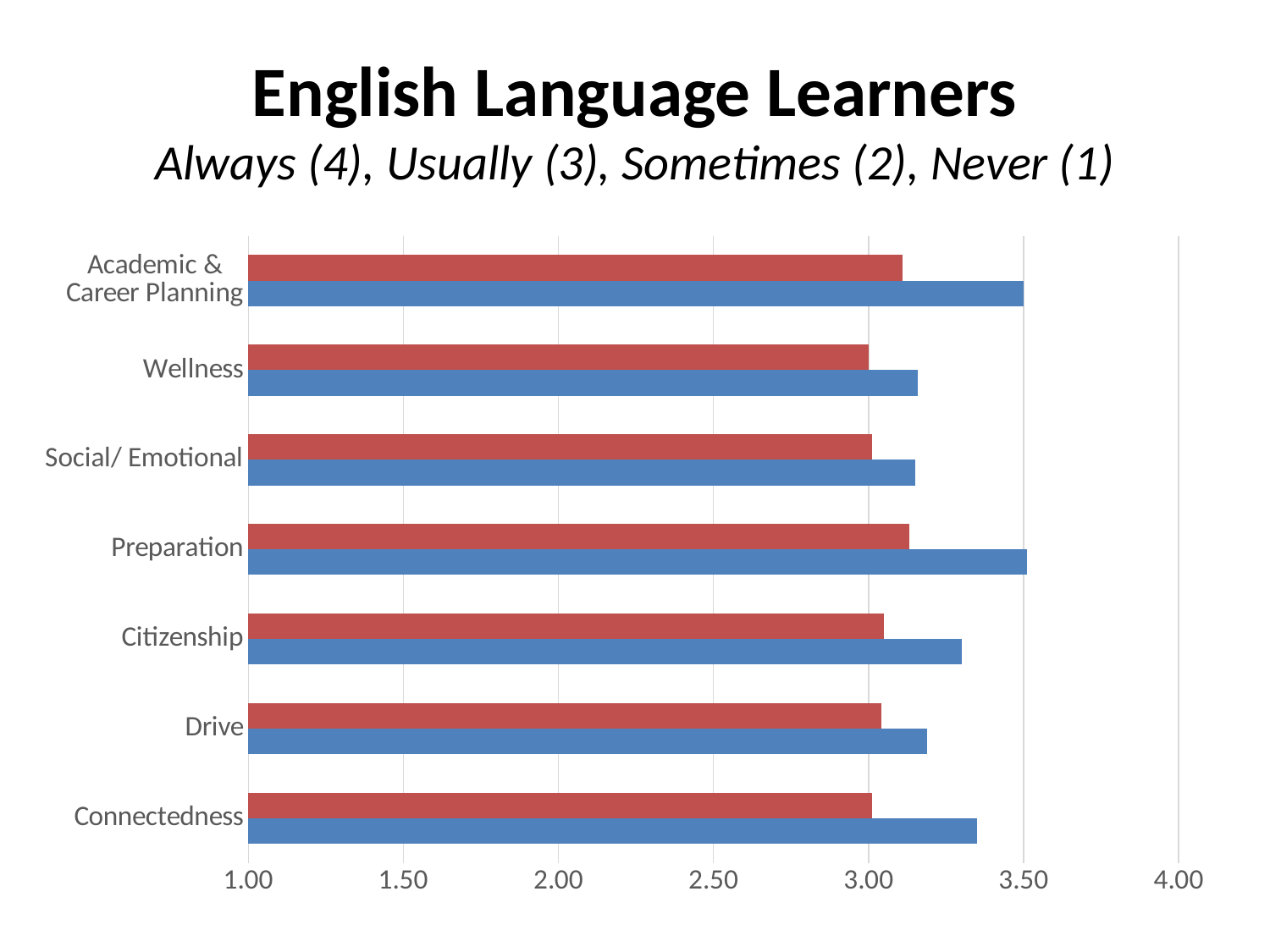
How many bars are plotted for each category in the chart? 2 Is the red bar for Academic & Career Planning greater or less than 3.50? less Is the blue bar for Drive greater or less than 3.00? greater How many categories are listed on the vertical axis of the chart? 7 Is the blue bar for Citizenship greater or less than 3.50? less For Preparation, which bar is longer, the blue bar or the red bar? the blue bar What is the highest value shown on the horizontal axis of the chart? 4.00 What kind of chart is shown on the slide? bar chart For Academic & Career Planning, which bar is longer, the blue bar or the red bar? the blue bar What is the title of the chart on the slide? English Language Learners For Connectedness, which bar is longer, the red bar or the blue bar? the blue bar